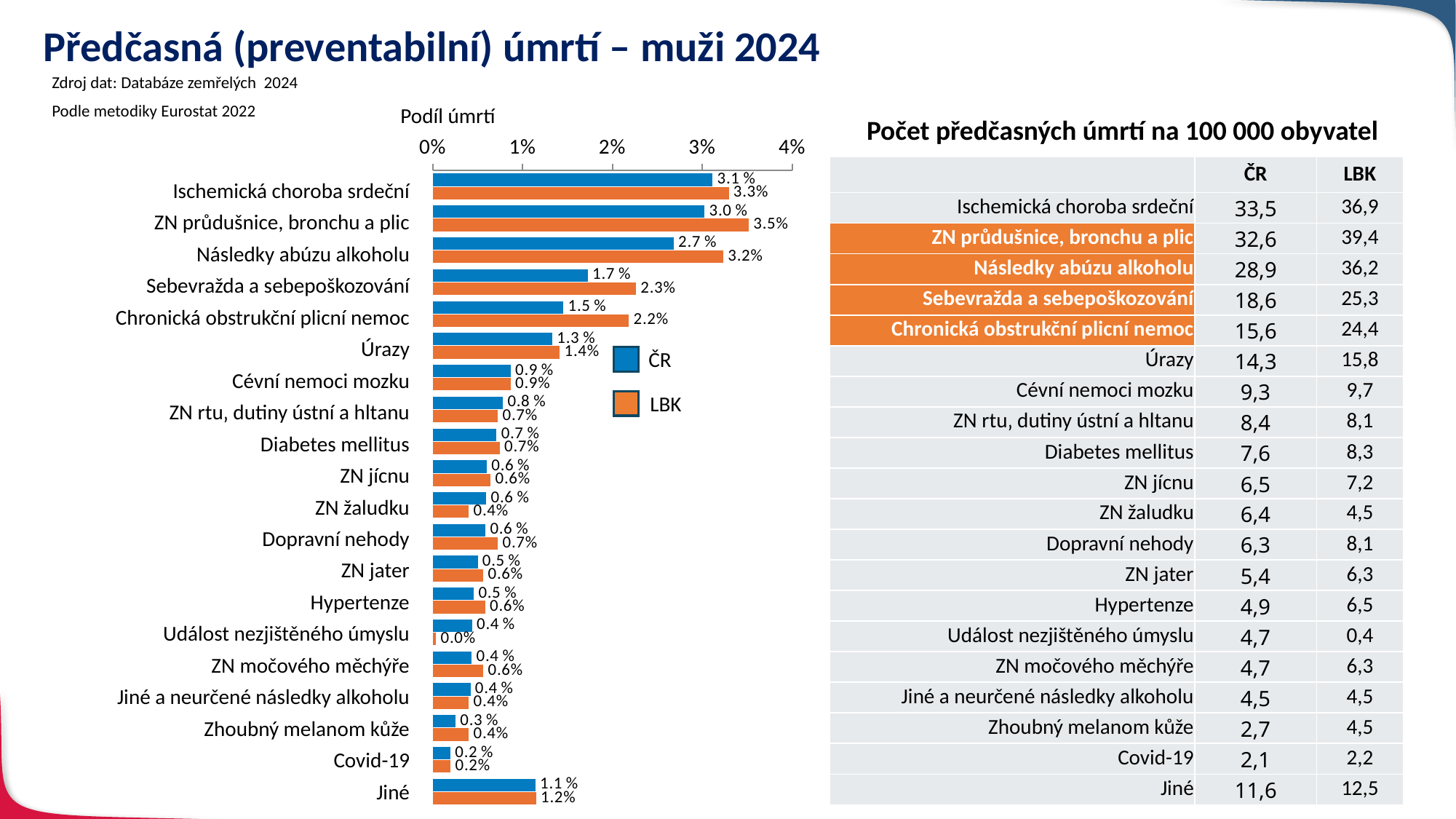
In the Podíl úmrtí chart, is the LBK value for ZN průdušnice, bronchu a plic greater or less than 3%? greater In the Podíl úmrtí chart, which is larger for Následky abúzu alkoholu, the ČR value or the LBK value? LBK What kind of chart is the Podíl úmrtí chart? Bar chart Which colour represents LBK in the Podíl úmrtí chart? Orange In the Podíl úmrtí chart, what is the difference between the LBK and ČR values for Sebevražda a sebepoškozování? 0.6 percentage points How many series does the legend of the Podíl úmrtí chart list? 2 How many categories are shown in the Podíl úmrtí chart? 20 What is the LBK value for ZN průdušnice, bronchu a plic in the Podíl úmrtí chart? 3.5% Which category has the highest LBK value in the Podíl úmrtí chart? ZN průdušnice, bronchu a plic Which category has the lowest LBK value in the Podíl úmrtí chart? Událost nezjištěného úmyslu What is the LBK value for Sebevražda a sebepoškozování in the Podíl úmrtí chart? 2.3% What is the ČR value for Ischemická choroba srdeční in the Podíl úmrtí chart? 3.1 %